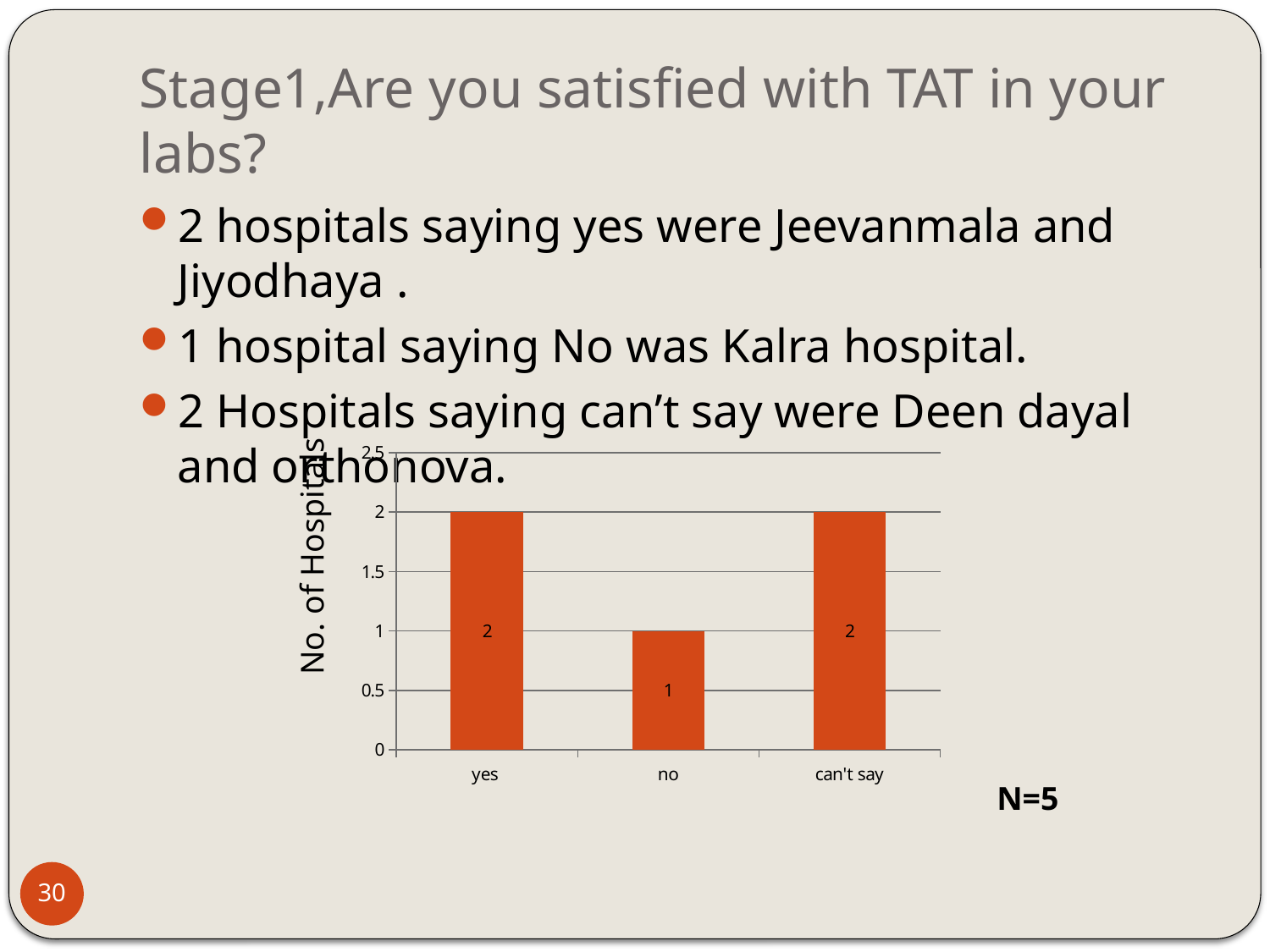
What is the difference between the values for "yes" and "no"? 1 What colour are the bars in the chart? orange Is the value for "yes" greater or less than 1.5? greater Which category has the lowest value in the bar chart? no What is the value for "yes" in the bar chart? 2 What is the value for "can't say" in the bar chart? 2 How many categories are shown on the x axis of the chart? 3 What kind of chart is shown on the slide? bar chart Which is larger, the value for "can't say" or the value for "no"? can't say Is the value for "no" greater or less than 1.5? less What is the value for "no" in the bar chart? 1 What is the label of the vertical axis of the chart? No. of Hospitals